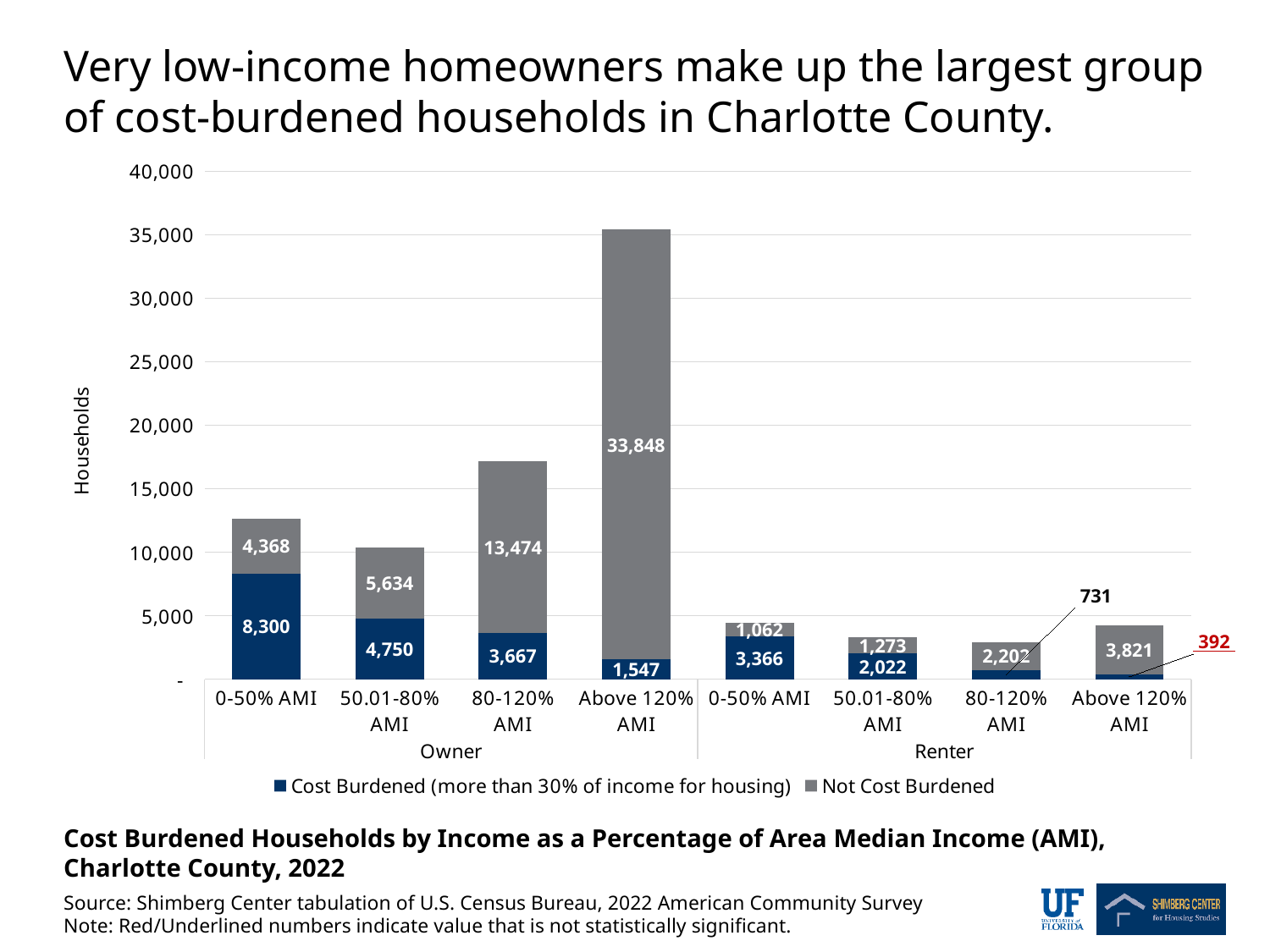
What is the number of not cost-burdened renter households in the 50.01-80% AMI group? 1,273 Which is larger: the number of cost-burdened renter households in the 0-50% AMI group or the number of cost-burdened owner households in the 80-120% AMI group? Owner, 80-120% AMI How many series does the legend list? 2 What is the difference between cost-burdened owner households in the 0-50% AMI group and the 50.01-80% AMI group? 3,550 Which category has the highest number of cost-burdened households? Owner, 0-50% AMI What is the total number of owner households in the 0-50% AMI group (cost burdened plus not cost burdened)? 12,668 What is the number of cost-burdened renter households in the 80-120% AMI group? 731 What is the number of cost-burdened owner households in the 0-50% AMI group? 8,300 What is the number of not cost-burdened owner households in the Above 120% AMI group? 33,848 Which category has the lowest number of cost-burdened households? Renter, Above 120% AMI What type of chart is shown on the slide? Stacked bar chart Which value on the chart is shown in red to indicate it is not statistically significant? 392